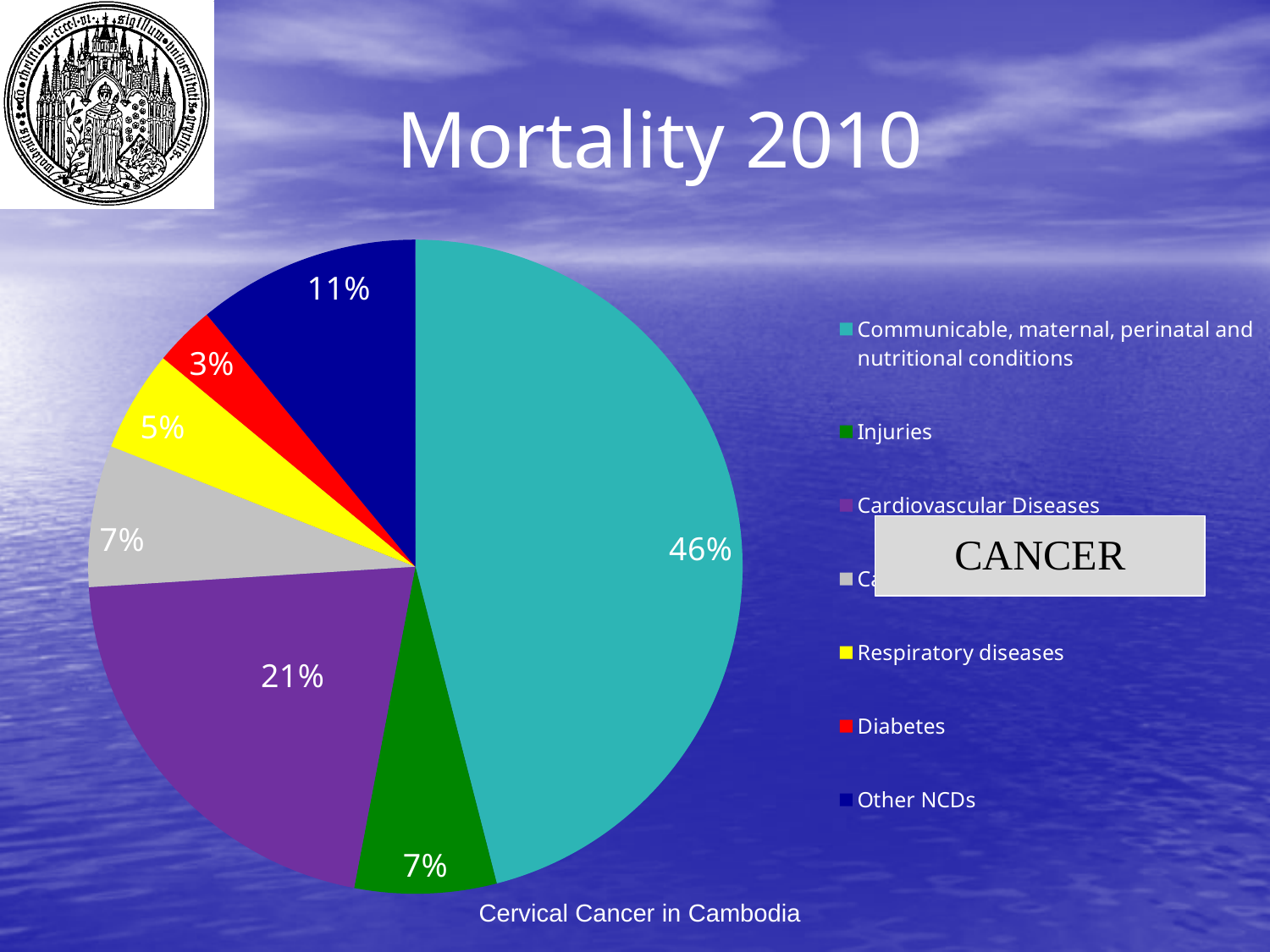
Which is larger, the share for Other NCDs or the share for Respiratory diseases? Other NCDs What type of chart is shown on the slide? Pie chart What percentage is shown for Injuries? 7% What percentage is shown for Respiratory diseases? 5% Which category has the largest slice of the pie? Communicable, maternal, perinatal and nutritional conditions What percentage is shown for Other NCDs? 11% What share of the pie does Communicable, maternal, perinatal and nutritional conditions account for? 46% What percentage is shown for Cardiovascular Diseases? 21% Which category has the smallest slice of the pie? Diabetes How many slices does the pie chart have? 7 How many percentage points larger is the Communicable, maternal, perinatal and nutritional conditions slice than the Cardiovascular Diseases slice? 25 percentage points What percentage is shown for Diabetes? 3%